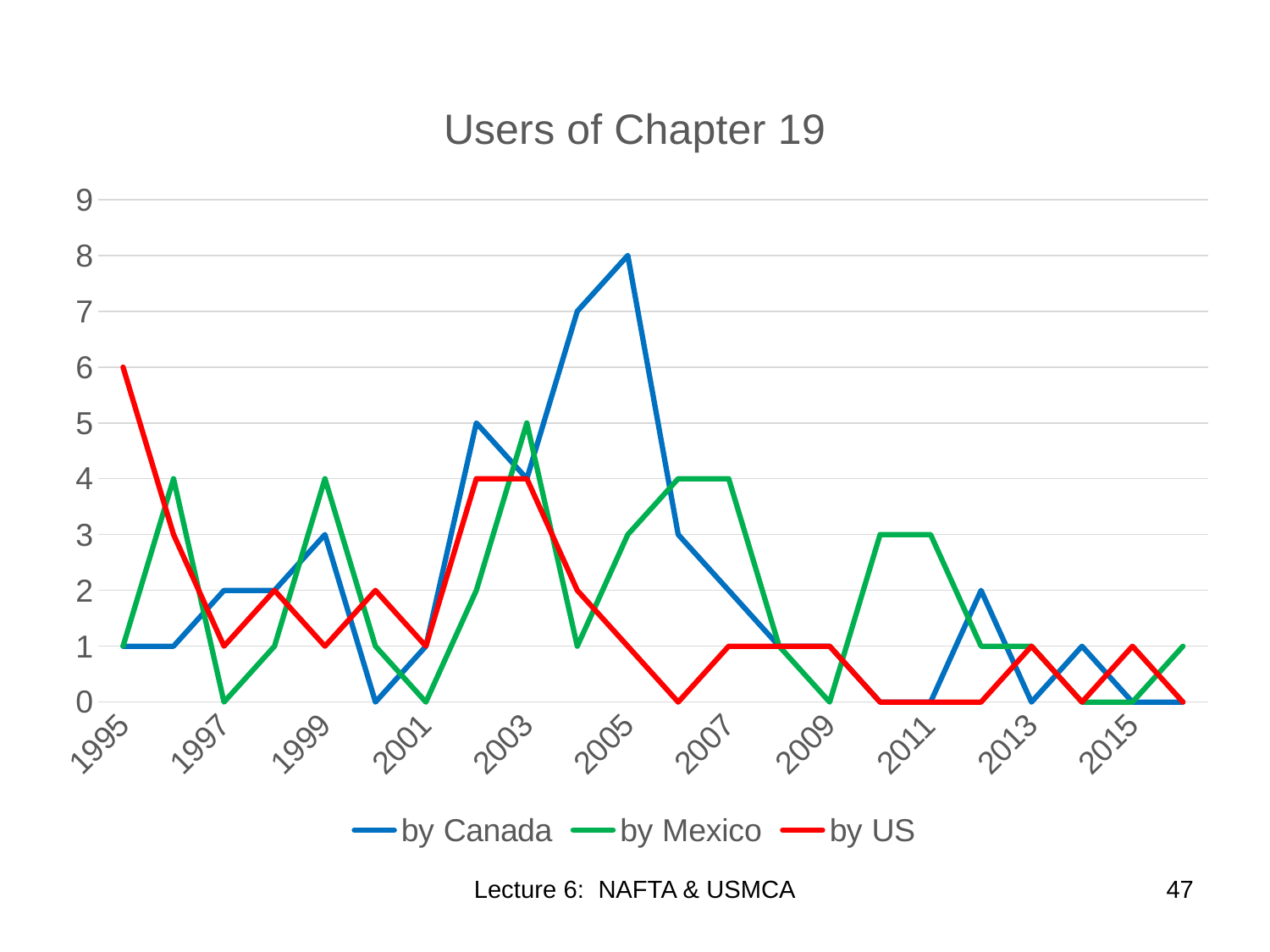
Does the 'by US' series rise or fall from 1995 to 1997? fall In which year does the 'by Canada' series reach its highest value? 2005 Which series has the higher value in 1995, 'by US' or 'by Canada'? by US What is the value for 'by US' in 1995? 6 What is the value for 'by Mexico' in 2003? 5 How many series does the legend list? 3 What is the value for 'by Canada' in 2005? 8 What is the title of the chart? Users of Chapter 19 Which colour is used for the 'by Mexico' series? green What is the difference between the 'by Canada' value and the 'by US' value in 2005? 7 In which year does the 'by US' series reach its highest value? 1995 What kind of chart is shown on the slide? line chart